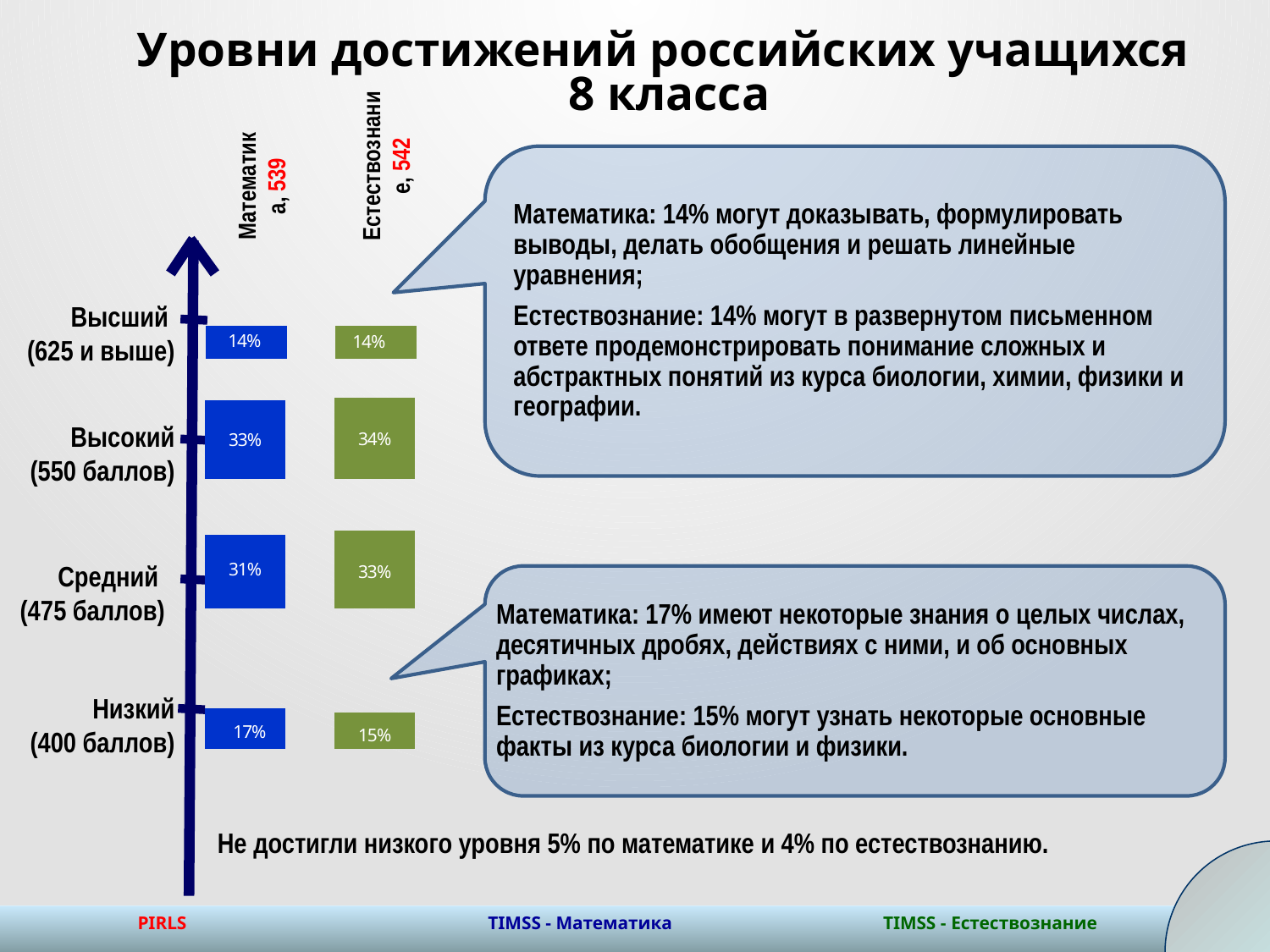
What is the difference between the Математика and Естествознание percentages at the Средний (475 баллов) level? 2% What average score is shown next to the Естествознание series label? 542 How many achievement levels are shown in the chart? 4 What percentage of students are at the Низкий (400 баллов) level in Естествознание? 15% How many series (subjects) does the chart show? 2 What percentage of students reached the Высший (625 и выше) level in Математика? 14% What percentage of students are at the Средний (475 баллов) level in Математика? 31% Which level has the highest percentage for Математика? Высокий (550 баллов) What percentage of students reached the Высокий (550 баллов) level in Естествознание? 34% What type of chart is used to show the achievement levels? Bar chart At the Низкий (400 баллов) level, which is larger: the Математика or the Естествознание percentage? Математика Which level has the lowest percentage for Естествознание? Высший (625 и выше)